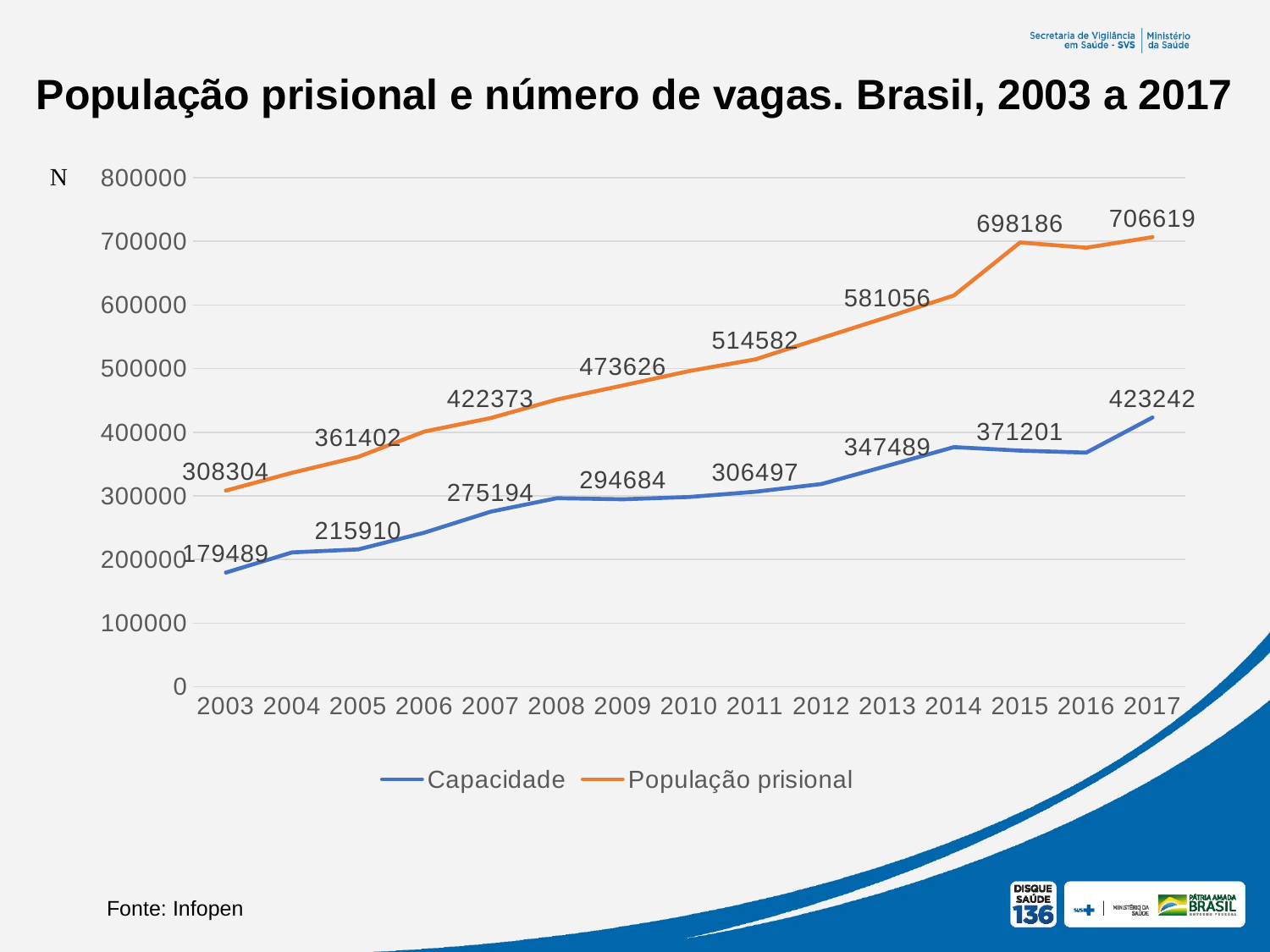
How many series does the legend list? 2 What is the value of Capacidade in 2013? 347489 How many years are shown on the x axis? 15 What is the value of Capacidade in 2003? 179489 Which series has the higher value in 2015, Capacidade or População prisional? População prisional What kind of chart is shown on the slide? Line chart Is the value of Capacidade in 2014 greater or less than 300000? greater What is the value of População prisional in 2011? 514582 Does the Capacidade series generally rise or fall from 2003 to 2017? Rise What is the difference between População prisional and Capacidade in 2003? 128815 What is the value of População prisional in 2017? 706619 What is the difference between População prisional and Capacidade in 2017? 283377